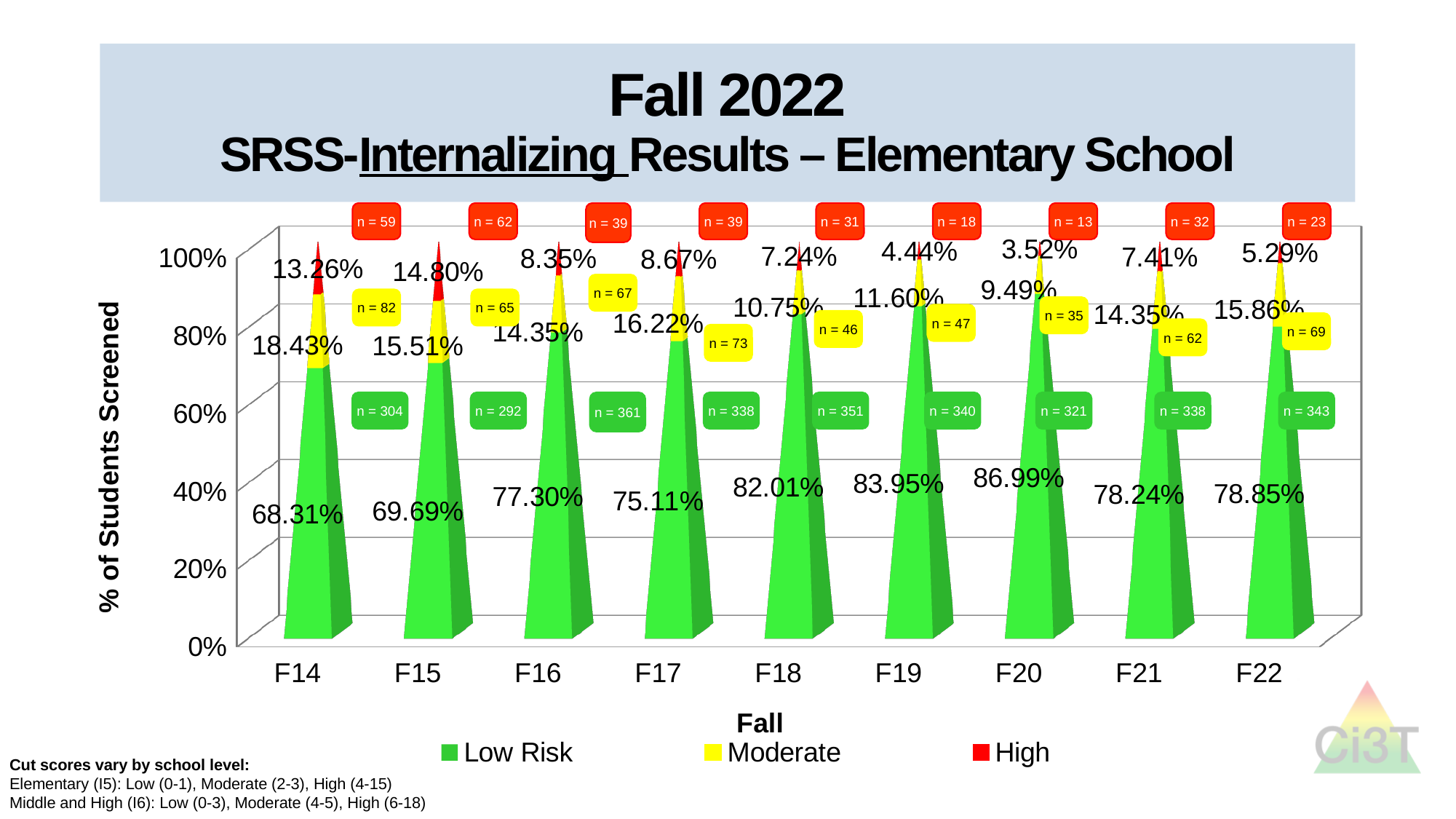
What is the Moderate percentage for F17? 16.22% Which fall has the highest Moderate percentage? F14 What is the Low Risk percentage for F20? 86.99% Which fall has the highest Low Risk percentage? F20 What kind of chart is shown on the slide? Stacked bar chart What is the n value shown for the Low Risk group in F16? n = 361 Which fall has the lowest High percentage? F20 What is the difference between the Low Risk percentage for F20 and for F14? 18.68% Which is larger, the Moderate percentage for F14 or for F22? F14 What is the High percentage for F15? 14.80% How many series does the legend list? 3 How many fall screening periods are shown on the x axis? 9